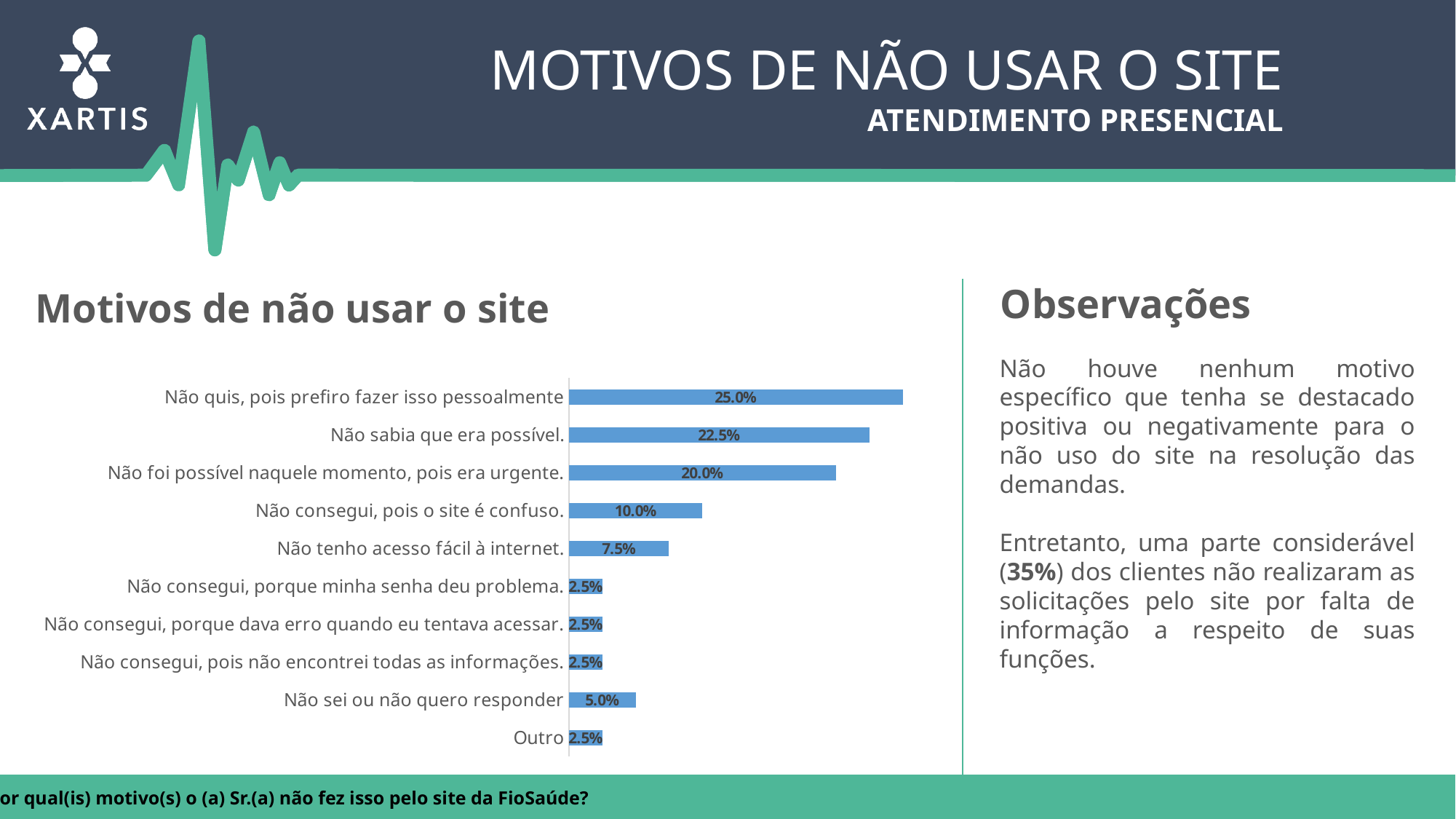
What is the value for "Não sei ou não quero responder"? 5.0% What is the title of the chart? Motivos de não usar o site What is the difference between "Não consegui, pois o site é confuso." and "Não tenho acesso fácil à internet."? 2.5% What is the value for "Não sabia que era possível."? 22.5% What is the value for "Não quis, pois prefiro fazer isso pessoalmente"? 25.0% How many categories are shown in the chart? 10 What type of chart is shown on the slide? Bar chart Which is larger: "Não consegui, pois o site é confuso." or "Não sei ou não quero responder"? Não consegui, pois o site é confuso. Which category has the highest value? Não quis, pois prefiro fazer isso pessoalmente What is the value for "Não tenho acesso fácil à internet."? 7.5% What is the difference between "Não quis, pois prefiro fazer isso pessoalmente" and "Não sabia que era possível."? 2.5% What is the value for "Não foi possível naquele momento, pois era urgente."? 20.0%